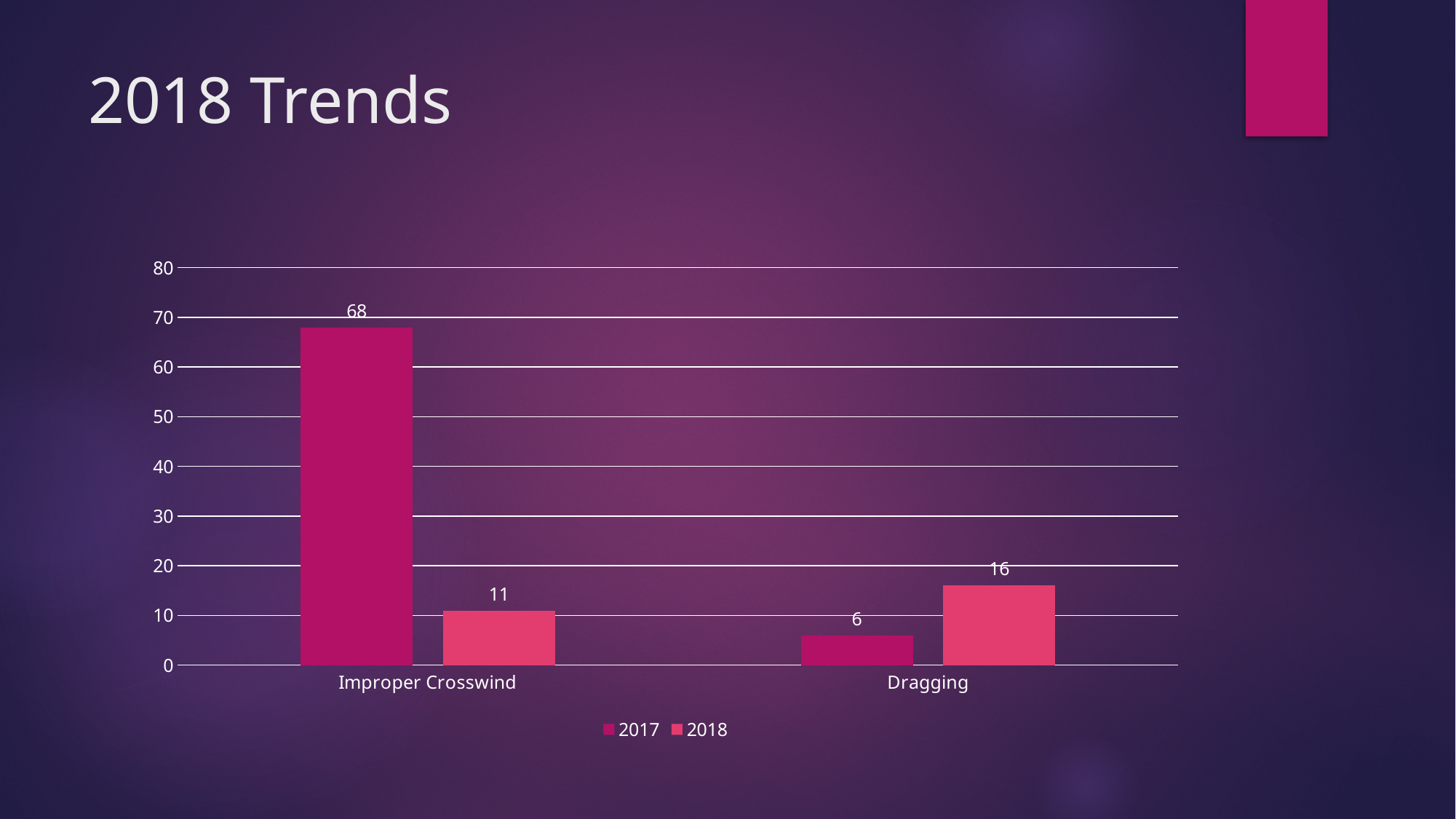
What is the 2018 value for Improper Crosswind? 11 What is the 2017 value for Dragging? 6 What is the 2017 value for Improper Crosswind? 68 What kind of chart is shown on the slide? Bar chart How many series does the legend list? 2 How many categories are shown on the x axis? 2 For Dragging, which year has the larger value, 2017 or 2018? 2018 Which category has the lowest 2018 value? Improper Crosswind Which category has the highest 2017 value? Improper Crosswind What is the difference between the 2017 and 2018 values for Improper Crosswind? 57 What is the difference between the 2018 and 2017 values for Dragging? 10 What is the 2018 value for Dragging? 16